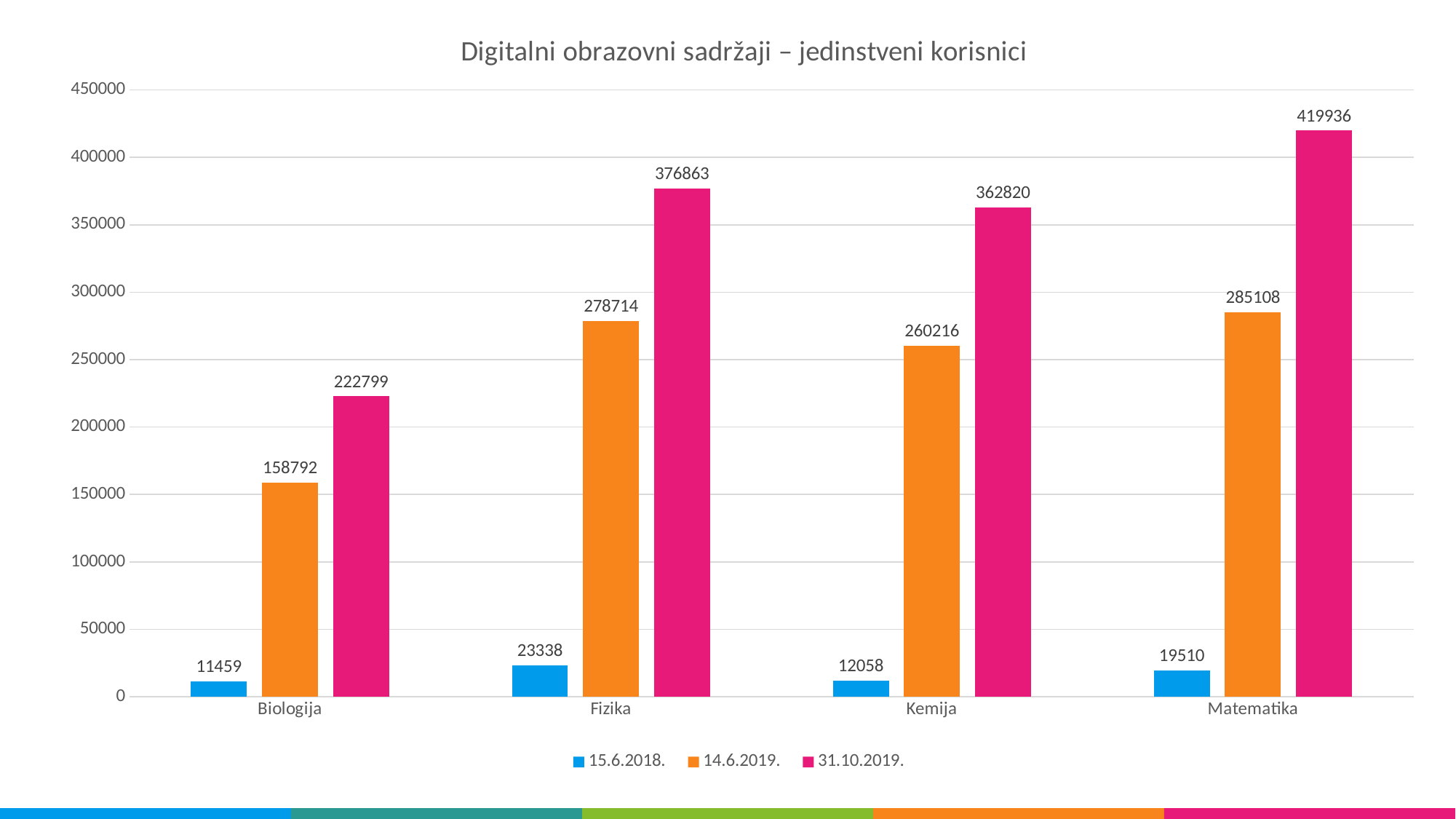
Which category has the lowest value in the 15.6.2018. series? Biologija What is the value for Fizika in the 31.10.2019. series? 376863 What is the difference between the 31.10.2019. and 14.6.2019. values for Matematika? 134828 Which category has the highest value in the 31.10.2019. series? Matematika What is the title of the chart? Digitalni obrazovni sadržaji – jedinstveni korisnici What is the value for Biologija in the 14.6.2019. series? 158792 How many series does the legend list? 3 Which is larger: the 14.6.2019. value for Fizika or the 14.6.2019. value for Kemija? Fizika Is the 31.10.2019. value for Biologija greater or less than 250000? less What kind of chart is shown on the slide? bar chart What is the value for Kemija in the 15.6.2018. series? 12058 How many categories are shown on the x axis? 4